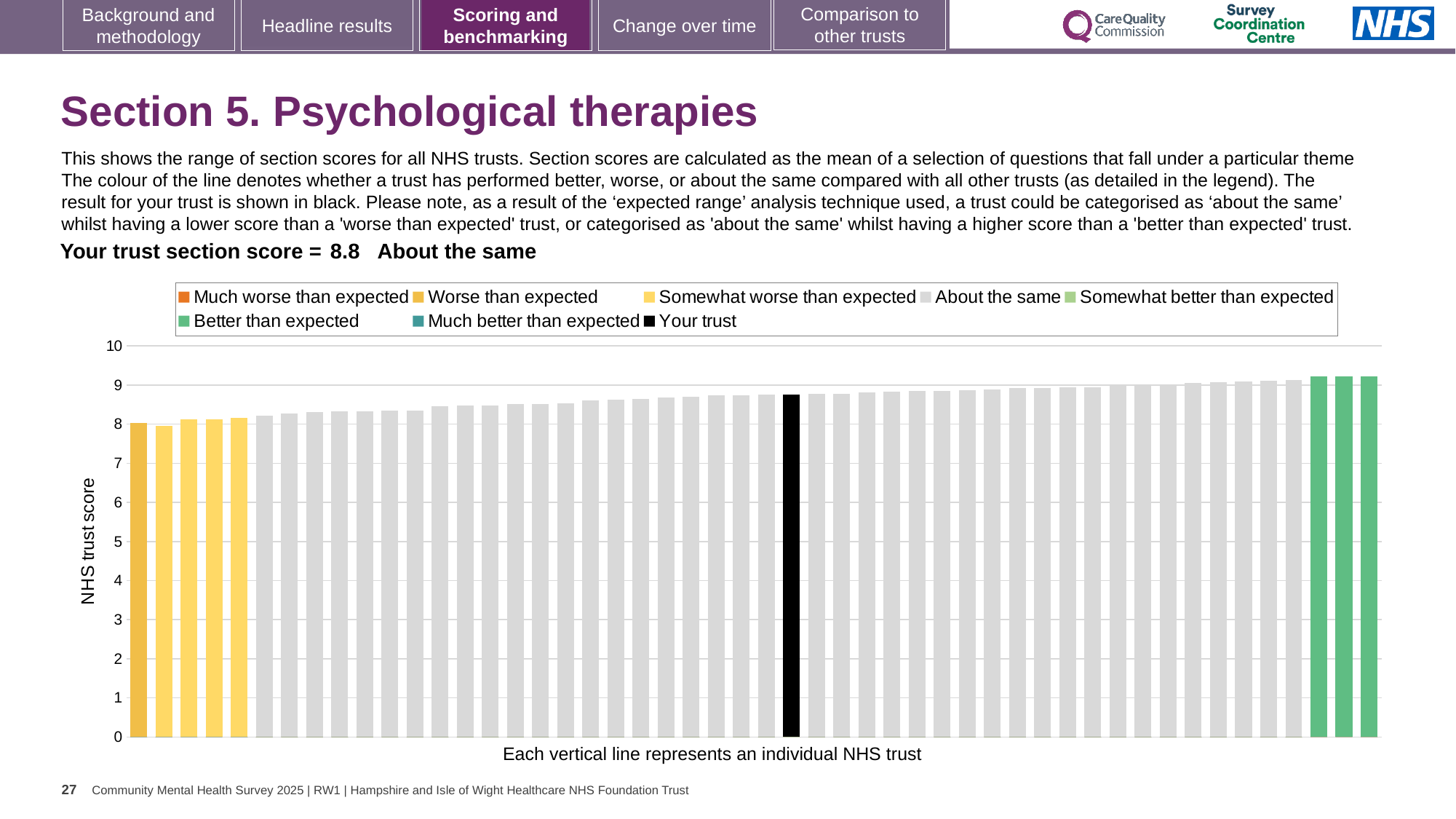
What is the section score for your trust shown on the slide? 8.8 What is the label on the vertical axis of the chart? NHS trust score Is the value of the black bar (your trust) greater or less than 8? greater What kind of chart is shown on the slide? bar chart How many bars are coloured green (better than expected)? 3 How many entries does the chart legend list? 8 Is the value of the leftmost bar greater or less than 7? greater Is the value of the rightmost bar greater or less than 9? greater Do the bar values rise or fall from left to right across the chart? rise Which is higher, the black bar or the leftmost bar? the black bar Which category is your trust placed in for this section? About the same